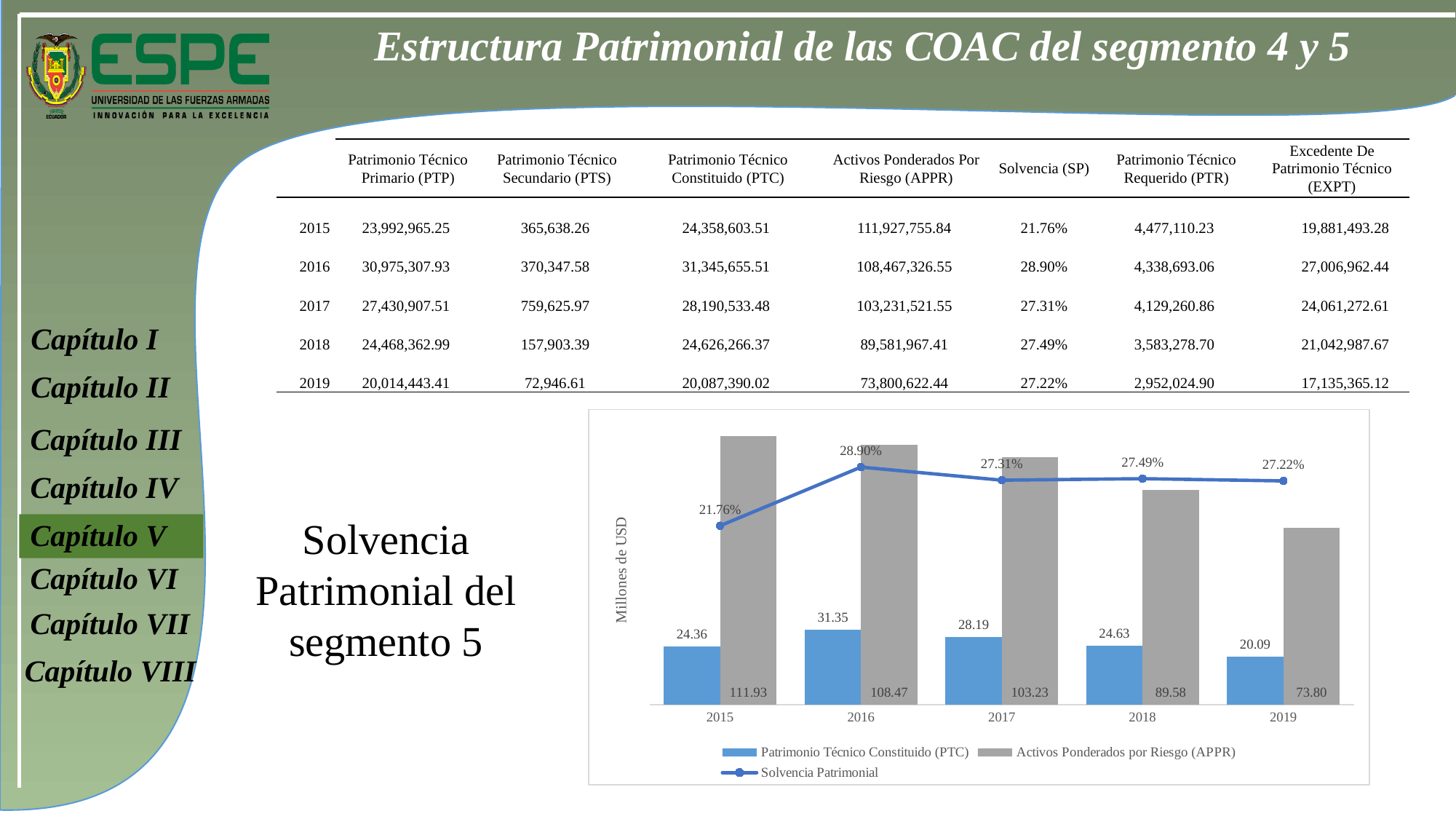
In which year is Activos Ponderados por Riesgo (APPR) highest in the chart? 2015 How many years are shown on the x axis of the chart? 5 In which year is Solvencia Patrimonial highest in the chart? 2016 Which is larger in the chart: the PTC value for 2017 or the PTC value for 2018? 2017 What is the value of Patrimonio Técnico Constituido (PTC) for 2016 in the chart? 31.35 Does the Activos Ponderados por Riesgo (APPR) series rise or fall from 2015 to 2019 in the chart? fall What is the value of Activos Ponderados por Riesgo (APPR) for 2019 in the chart? 73.80 What is the Solvencia Patrimonial value for 2015 in the chart? 21.76% What is the difference between the APPR values for 2015 and 2016 in the chart? 3.46 How many series does the chart legend list? 3 What is the y-axis label of the chart? Millones de USD In which year is Patrimonio Técnico Constituido (PTC) lowest in the chart? 2019